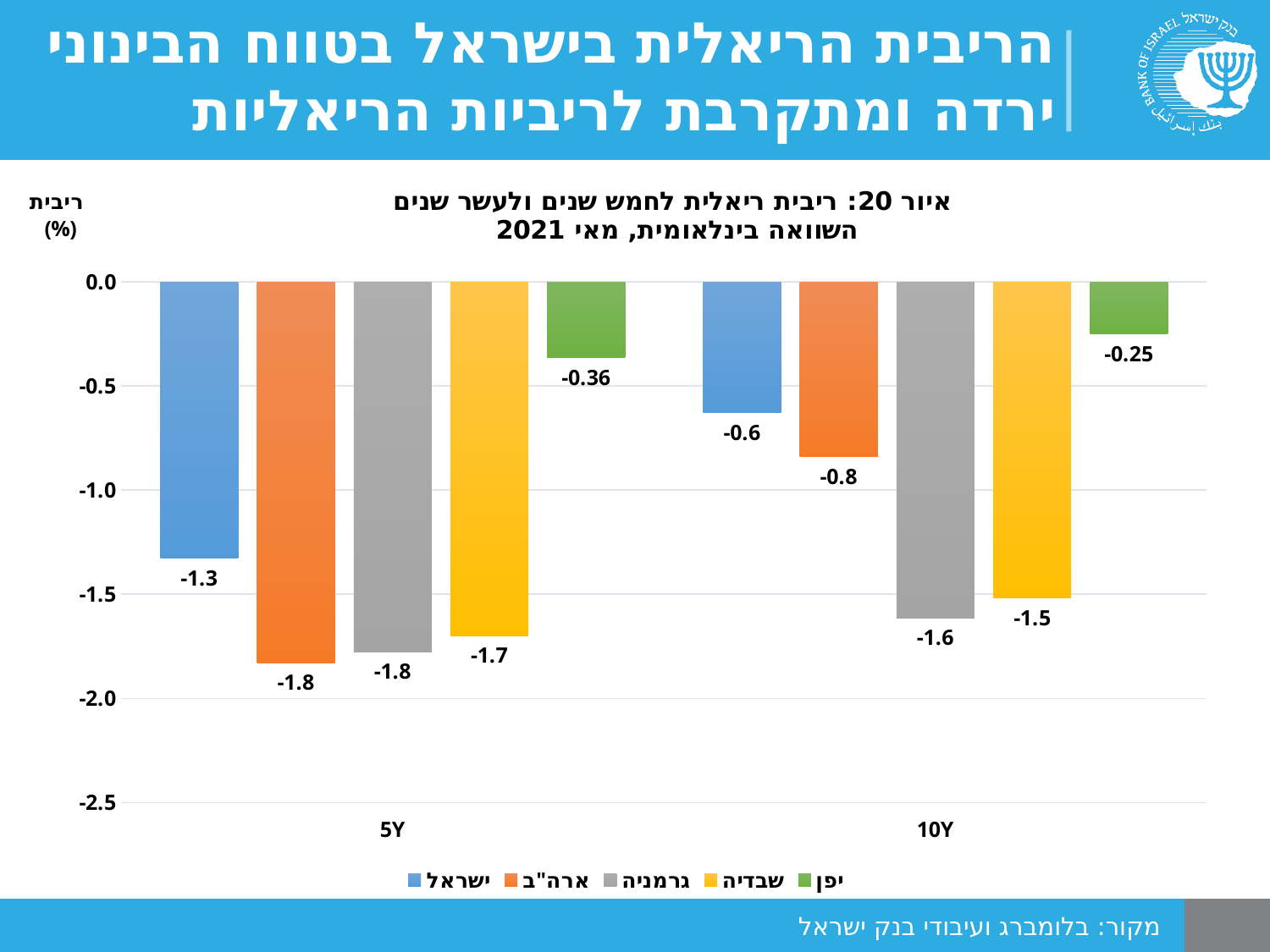
Which is larger, the value for ארה"ב in the 5Y group or in the 10Y group? 10Y What is the value for יפן in the 10Y group? -0.25 What is the value for גרמניה in the 10Y group? -1.6 What is the value for שבדיה in the 5Y group? -1.7 What kind of chart is shown on the slide? Bar chart What colour represents שבדיה in the chart? Yellow What is the value for ישראל in the 5Y group? -1.3 How many series does the legend list? 5 Which series has the highest (least negative) value in the 5Y group? יפן How many category groups are shown on the x axis? 2 Which series has the lowest value in the 10Y group? גרמניה What is the difference between the value for ישראל in the 5Y group and in the 10Y group? 0.7